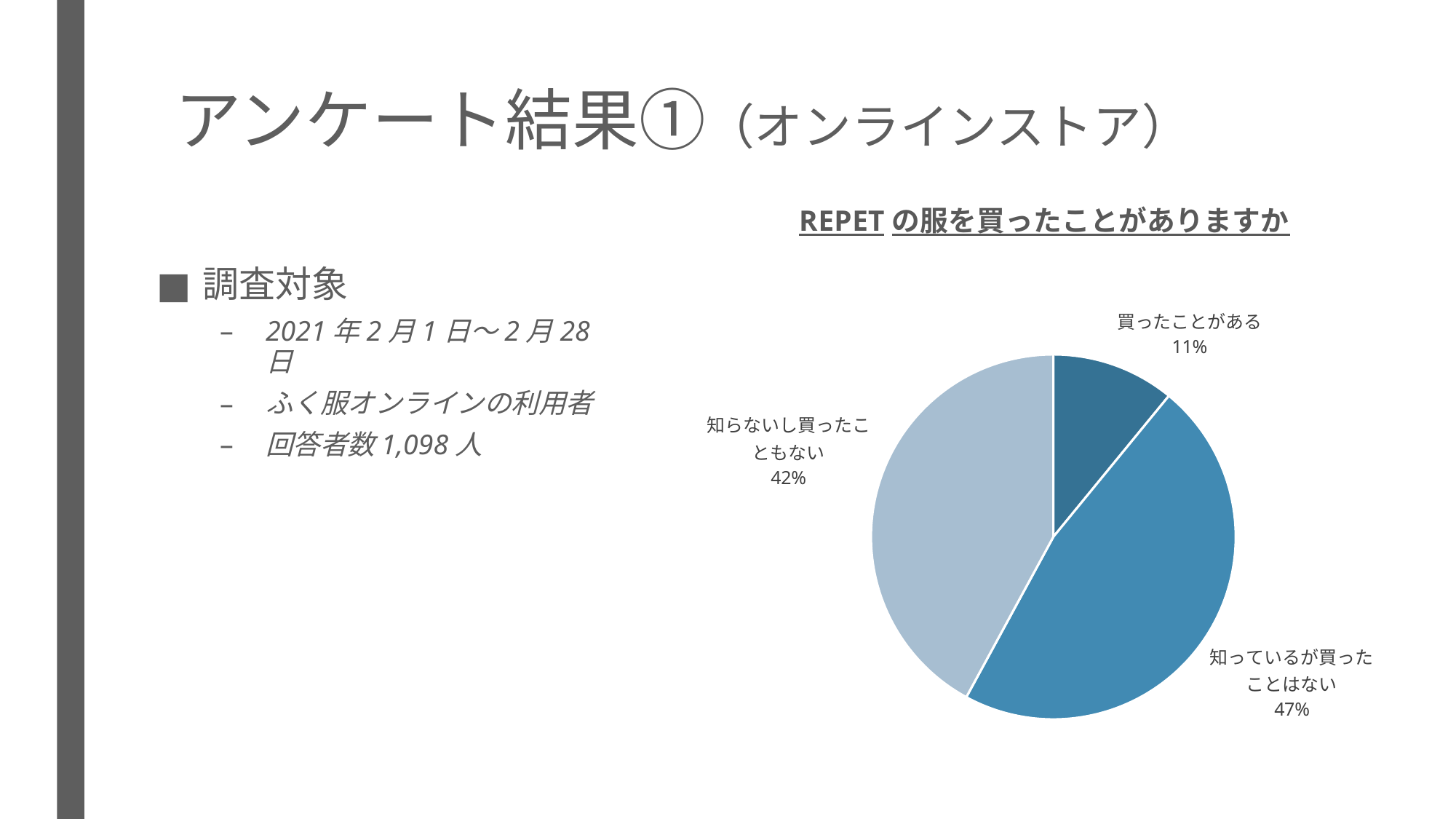
Which category has the largest share of the pie? 知っているが買ったことはない What is the share for 知っているが買ったことはない? 47% Which is larger, the share for 知らないし買ったこともない or the share for 買ったことがある? 知らないし買ったこともない What is the share for 買ったことがある? 11% Which slice of the pie is the lightest in colour? 知らないし買ったこともない What is the title of the pie chart? REPET の服を買ったことがありますか What is the difference in percentage points between 知っているが買ったことはない and 知らないし買ったこともない? 5 What is the share for 知らないし買ったこともない? 42% What is the difference in percentage points between 知らないし買ったこともない and 買ったことがある? 31 Which category has the smallest share of the pie? 買ったことがある How many slices does the pie chart have? 3 What kind of chart is shown on the slide? pie chart